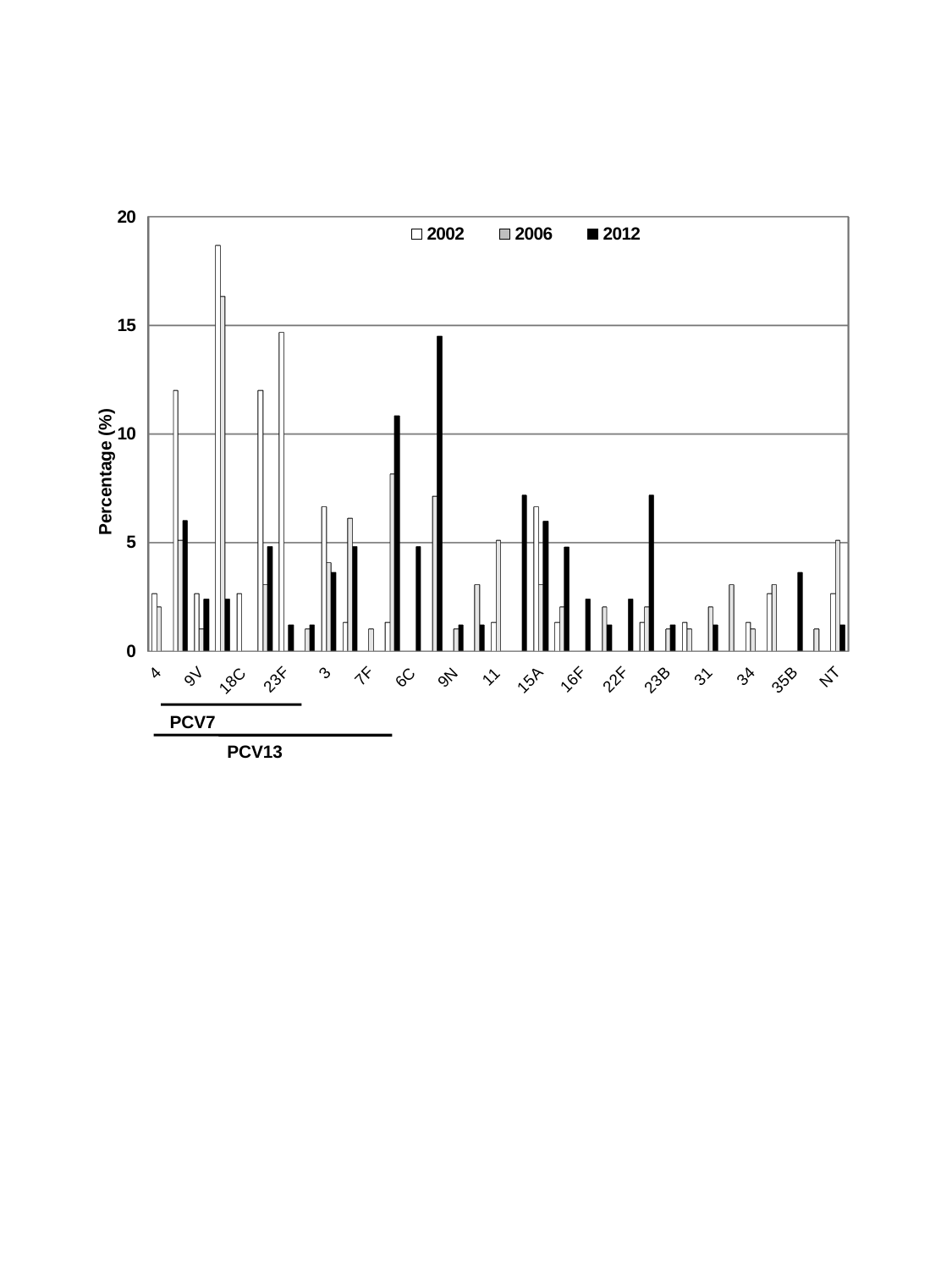
What are the three series named in the legend? 2002, 2006, 2012 Is the tallest bar on the chart greater or less than 15? greater Which series contains the tallest bar on the chart? 2002 How many category labels are printed along the x axis? 17 What kind of chart is shown on the slide? bar chart How many series does the legend list? 3 What is the title of the vertical axis? Percentage (%) Which vaccine group label covers the wider range of serotypes under the x axis, PCV7 or PCV13? PCV13 Is the tallest 2012 bar greater or less than 10? greater Is the tallest 2006 bar greater or less than 15? greater What is the highest value shown on the vertical axis? 20